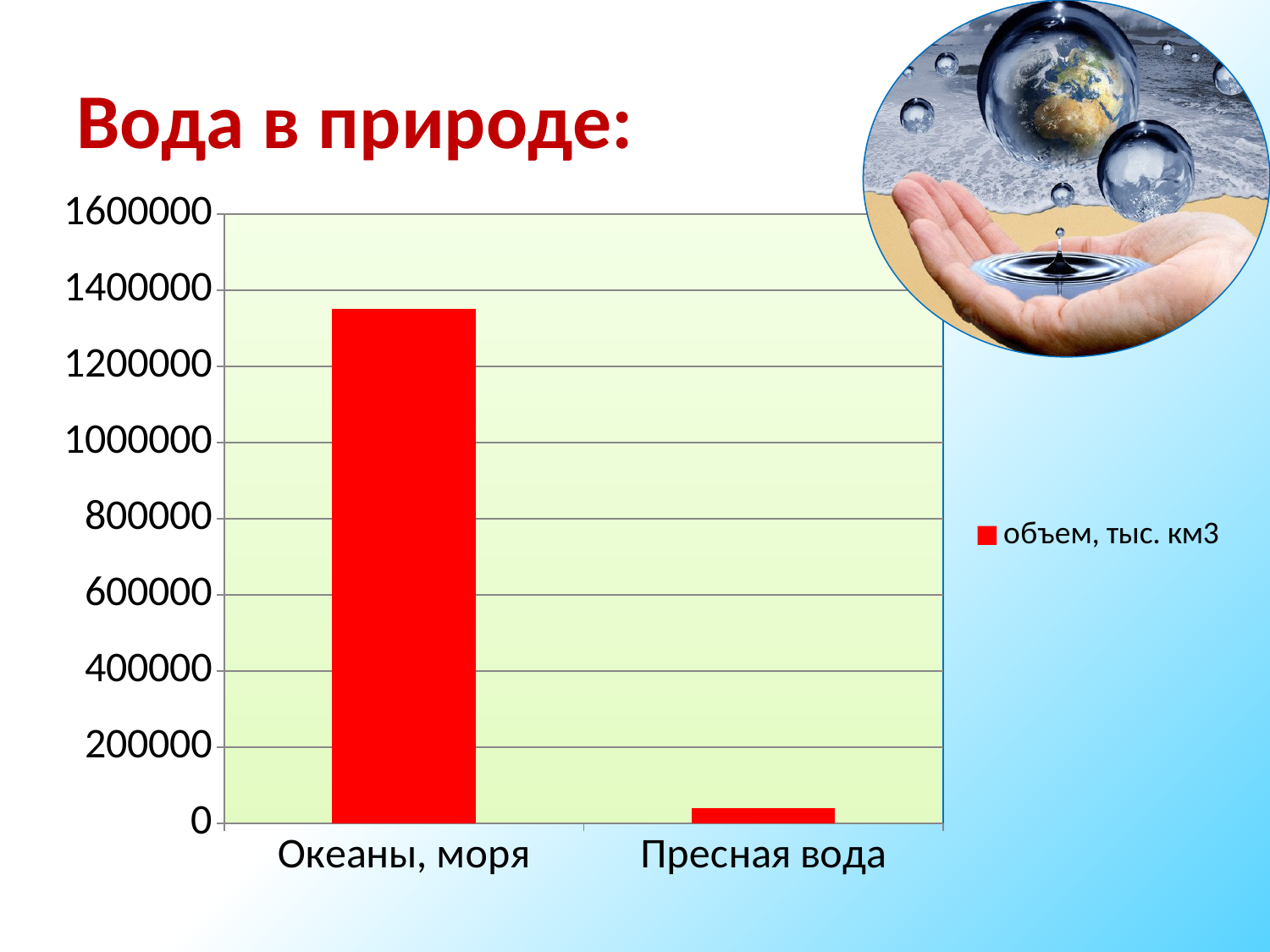
Which is larger, the value for Океаны, моря or the value for Пресная вода? Океаны, моря Is the value for Пресная вода greater or less than 200000? less Is the value for Океаны, моря greater or less than 1400000? less What is the name of the series shown in the chart legend? объем, тыс. км3 How many categories are shown on the x axis of the chart? 2 Is the value for Океаны, моря greater or less than 1200000? greater Which category has the lowest value in the chart? Пресная вода What colour are the bars in the chart? red How many series does the chart legend list? 1 What kind of chart is shown on the slide? bar chart Which category has the highest value in the chart? Океаны, моря